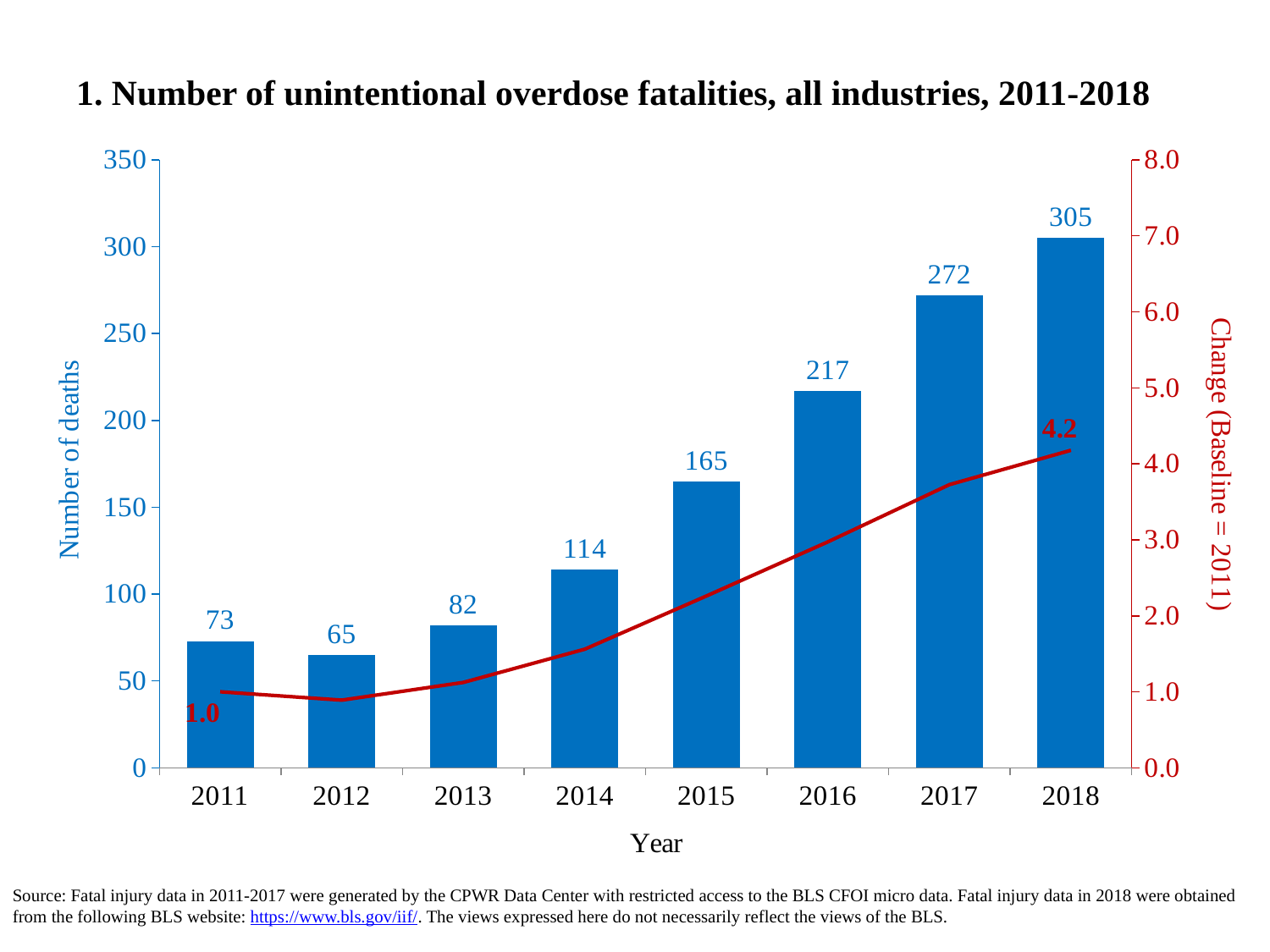
How many years are shown on the x axis? 8 Is the change (baseline = 2011) value for 2016 greater or less than 2.0? greater Do the number of deaths generally rise or fall from 2012 to 2018? Rise What is the change (baseline = 2011) value labelled for 2018? 4.2 Which year has the lowest number of deaths? 2012 What is the number of deaths in 2015? 165 Which year has more deaths, 2013 or 2014? 2014 What is the label of the right-hand y axis? Change (Baseline = 2011) What is the number of deaths in 2018? 305 What kind of chart is this? Combined bar and line chart Which year has the highest number of deaths? 2018 What is the difference in the number of deaths between 2018 and 2017? 33